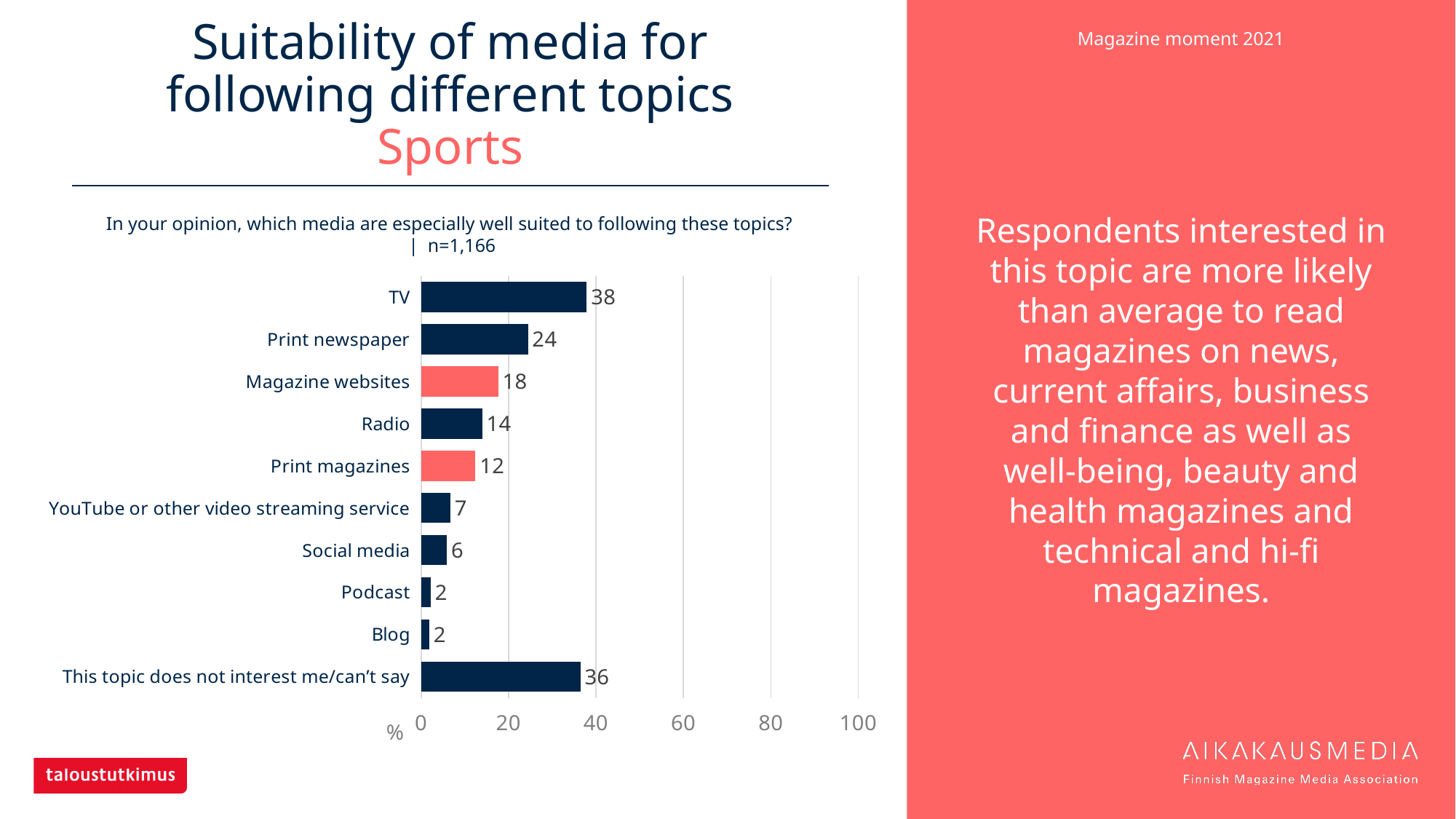
What is the value for YouTube or other video streaming service? 7 What is the value for Print magazines? 12 What is the value for Social media? 6 What is the sample size (n) stated above the chart? n=1,166 How many categories are shown in the chart? 10 Is the value for 'This topic does not interest me/can't say' greater or less than 20? greater Which media category has the highest value? TV What is the difference between the values for TV and Print newspaper? 14 What is the value for TV? 38 Which is larger, the value for Magazine websites or the value for Radio? Magazine websites What kind of chart is shown on the slide? bar chart Which two categories are shown with red bars? Magazine websites and Print magazines